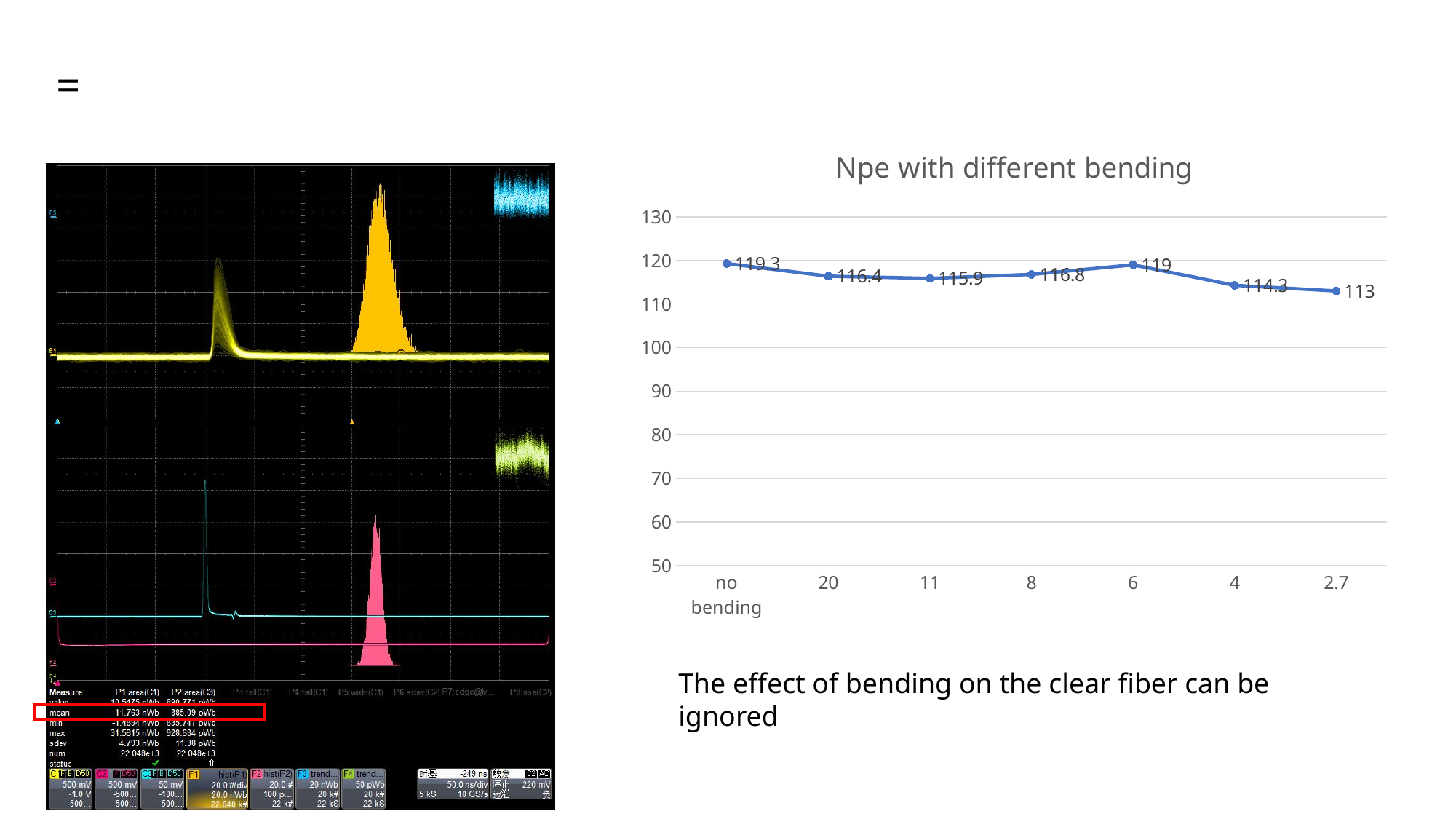
In the 'Npe with different bending' chart, which is larger, the value at bending 20 or at bending 4? 20 In the 'Npe with different bending' chart, what is the value at bending 2.7? 113 How many data points are plotted in the 'Npe with different bending' chart? 7 In the 'Npe with different bending' chart, which category has the highest value? no bending In the 'Npe with different bending' chart, what is the value at bending 6? 119 What is the title of the line chart? Npe with different bending In the 'Npe with different bending' chart, what is the value at bending 11? 115.9 In the 'Npe with different bending' chart, which category has the lowest value? 2.7 In the 'Npe with different bending' chart, what is the difference between the values for 'no bending' and 2.7? 6.3 What kind of chart is 'Npe with different bending'? line chart In the 'Npe with different bending' chart, is the value at bending 8 greater or less than 110? greater In the 'Npe with different bending' chart, what is the value for 'no bending'? 119.3